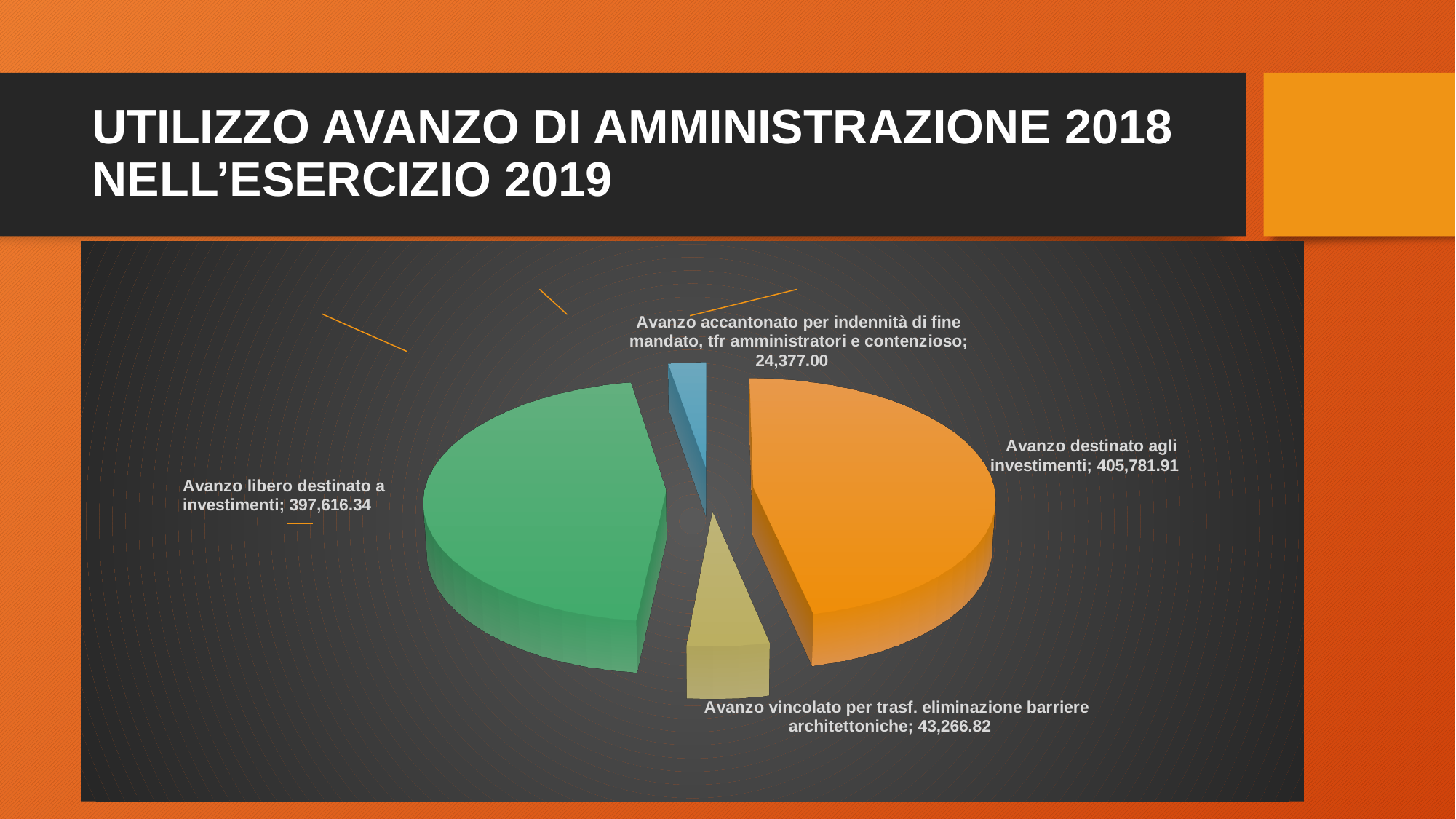
Which category has the largest value in the pie chart? Avanzo destinato agli investimenti What kind of chart is shown on the slide? Pie chart What is the difference between 'Avanzo vincolato per trasf. eliminazione barriere architettoniche' and 'Avanzo accantonato per indennità di fine mandato, tfr amministratori e contenzioso'? 18,889.82 What is the value for 'Avanzo accantonato per indennità di fine mandato, tfr amministratori e contenzioso'? 24,377.00 What is the value for 'Avanzo destinato agli investimenti'? 405,781.91 What is the value for 'Avanzo vincolato per trasf. eliminazione barriere architettoniche'? 43,266.82 What is the difference between 'Avanzo destinato agli investimenti' and 'Avanzo libero destinato a investimenti'? 8,165.57 What is the value for 'Avanzo libero destinato a investimenti'? 397,616.34 Which category has the smallest value in the pie chart? Avanzo accantonato per indennità di fine mandato, tfr amministratori e contenzioso How many slices does the pie chart have? 4 Which is larger: 'Avanzo vincolato per trasf. eliminazione barriere architettoniche' or 'Avanzo accantonato per indennità di fine mandato, tfr amministratori e contenzioso'? Avanzo vincolato per trasf. eliminazione barriere architettoniche Which category is represented by the orange slice of the pie chart? Avanzo destinato agli investimenti